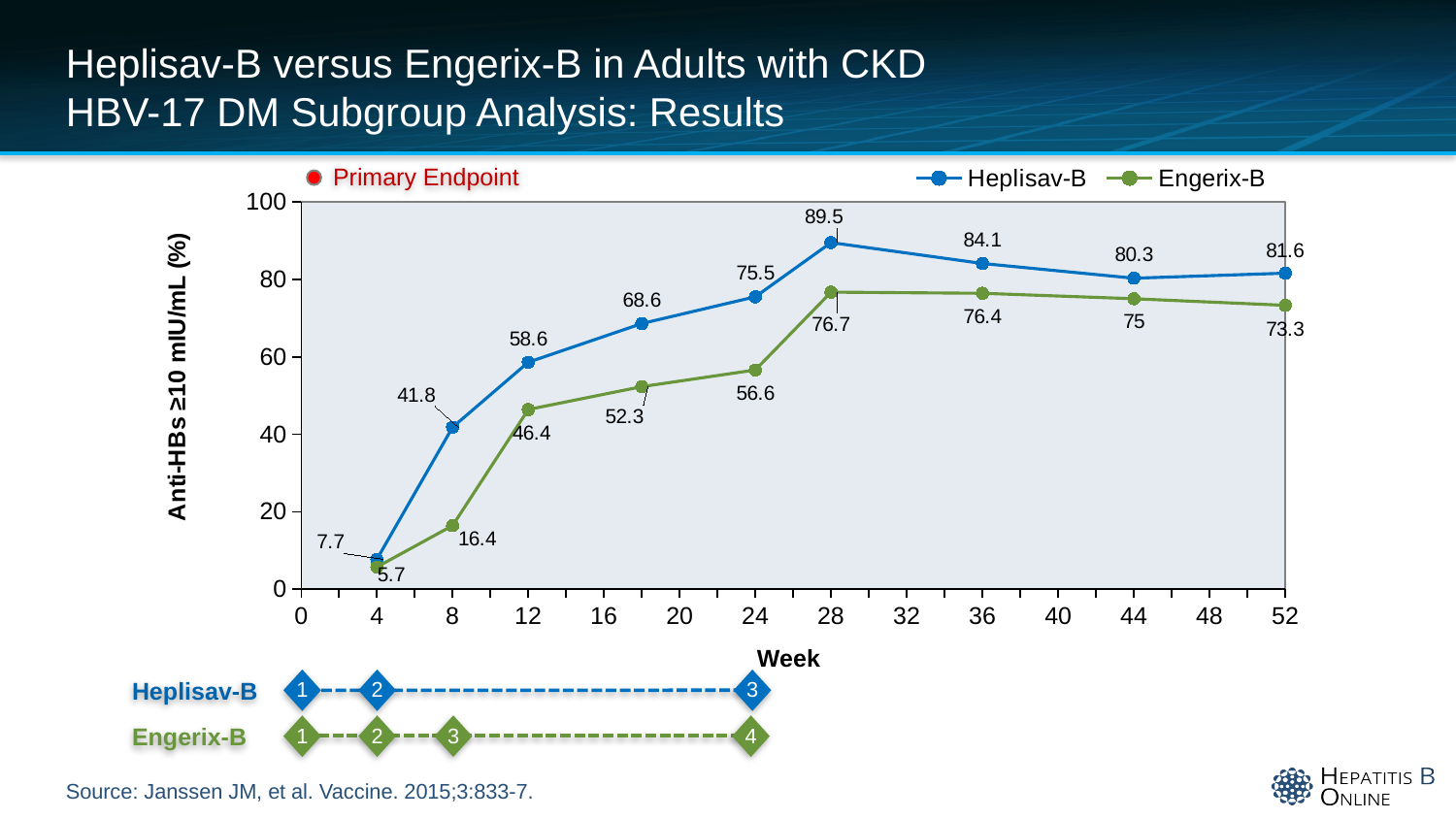
What is the label on the y axis of the chart? Anti-HBs ≥10 mIU/mL (%) How many data points are plotted for the Heplisav-B series? 9 What type of chart is shown on the slide? line chart Is the Engerix-B value at week 28 greater or less than 60? greater At which week does the Heplisav-B series reach its highest value? 28 At which week is the Engerix-B series at its lowest value? 4 What is the Engerix-B value at week 12? 46.4 What is the Heplisav-B value at week 28? 89.5 How many series does the chart legend list? 2 What is the difference between the Heplisav-B and Engerix-B values at week 8? 25.4 Which series has the higher value at week 24, Heplisav-B or Engerix-B? Heplisav-B What is the Engerix-B value at week 52? 73.3